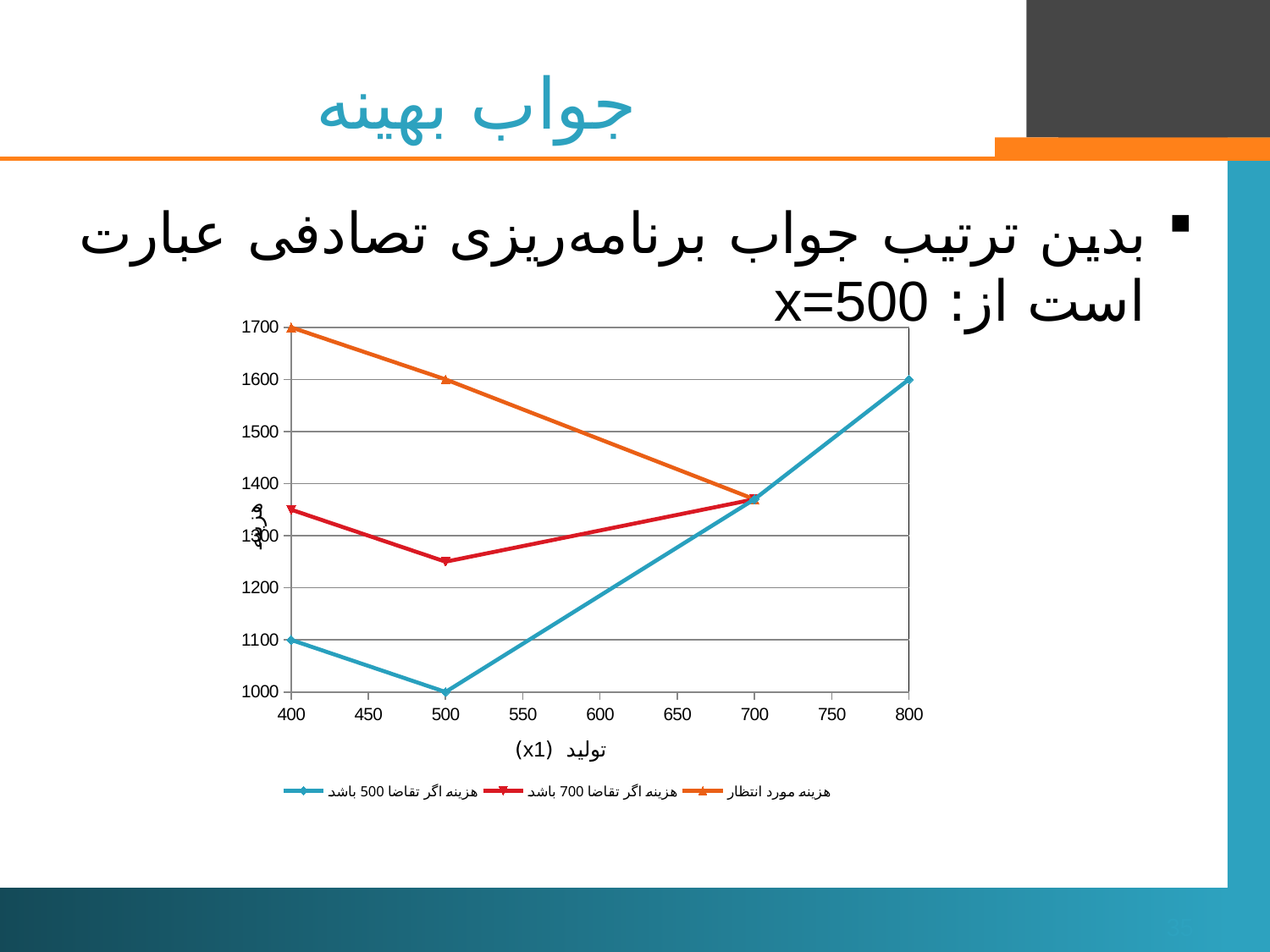
Is the value of the series 'هزینه اگر تقاضا 700 باشد' at x1 = 500 greater or less than 1300? less Does the series 'هزینه مورد انتظار' rise or fall as x1 increases from 400 to 700? fall What is the value of the series 'هزینه اگر تقاضا 500 باشد' at x1 = 800? 1600 Is the value of the series 'هزینه مورد انتظار' at x1 = 700 greater or less than 1400? less How many series does the chart's legend list? 3 What is the value of the series 'هزینه اگر تقاضا 500 باشد' at x1 = 400? 1100 What is the difference between the values of the series 'هزینه اگر تقاضا 500 باشد' at x1 = 800 and at x1 = 500? 600 At which x1 value does the series 'هزینه اگر تقاضا 500 باشد' reach its lowest point? 500 What is the value of the series 'هزینه مورد انتظار' at x1 = 500? 1600 What is the value of the series 'هزینه مورد انتظار' at x1 = 400? 1700 What kind of chart is shown on the slide? line chart What is the value of the series 'هزینه اگر تقاضا 500 باشد' at x1 = 500? 1000